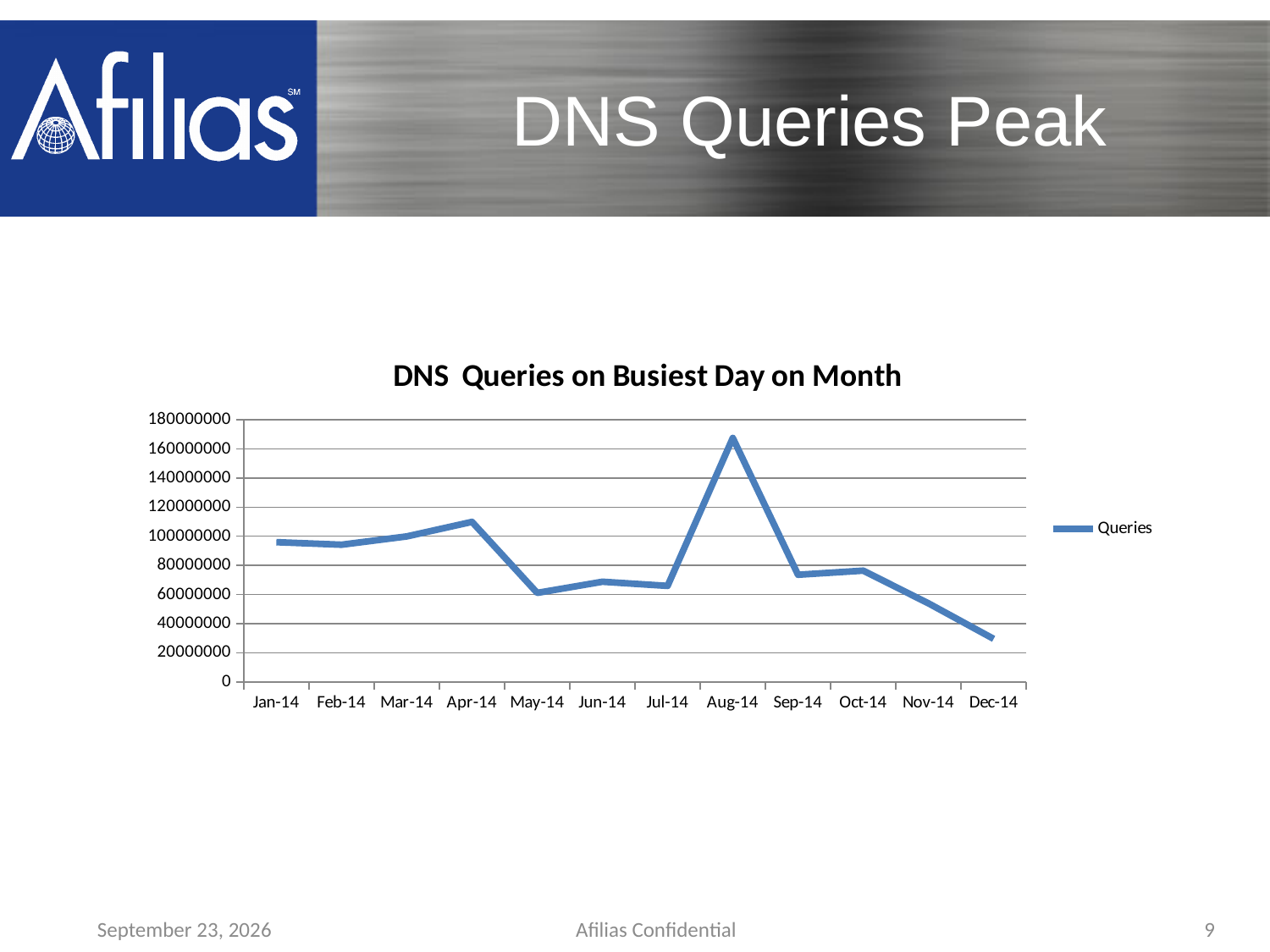
What is the name of the series shown in the legend? Queries How many months are plotted along the x axis? 12 Do the values rise or fall from Aug-14 to Dec-14? fall What is the title of the chart? DNS Queries on Busiest Day on Month Which month has the lowest number of queries? Dec-14 Which month has the highest number of queries? Aug-14 Is the value for Dec-14 greater or less than 40000000? less Which has more queries, Apr-14 or Jan-14? Apr-14 How many series does the legend list? 1 Is the value for Aug-14 greater or less than 160000000? greater What kind of chart is shown on the slide? line chart Is the value for Apr-14 greater or less than 100000000? greater